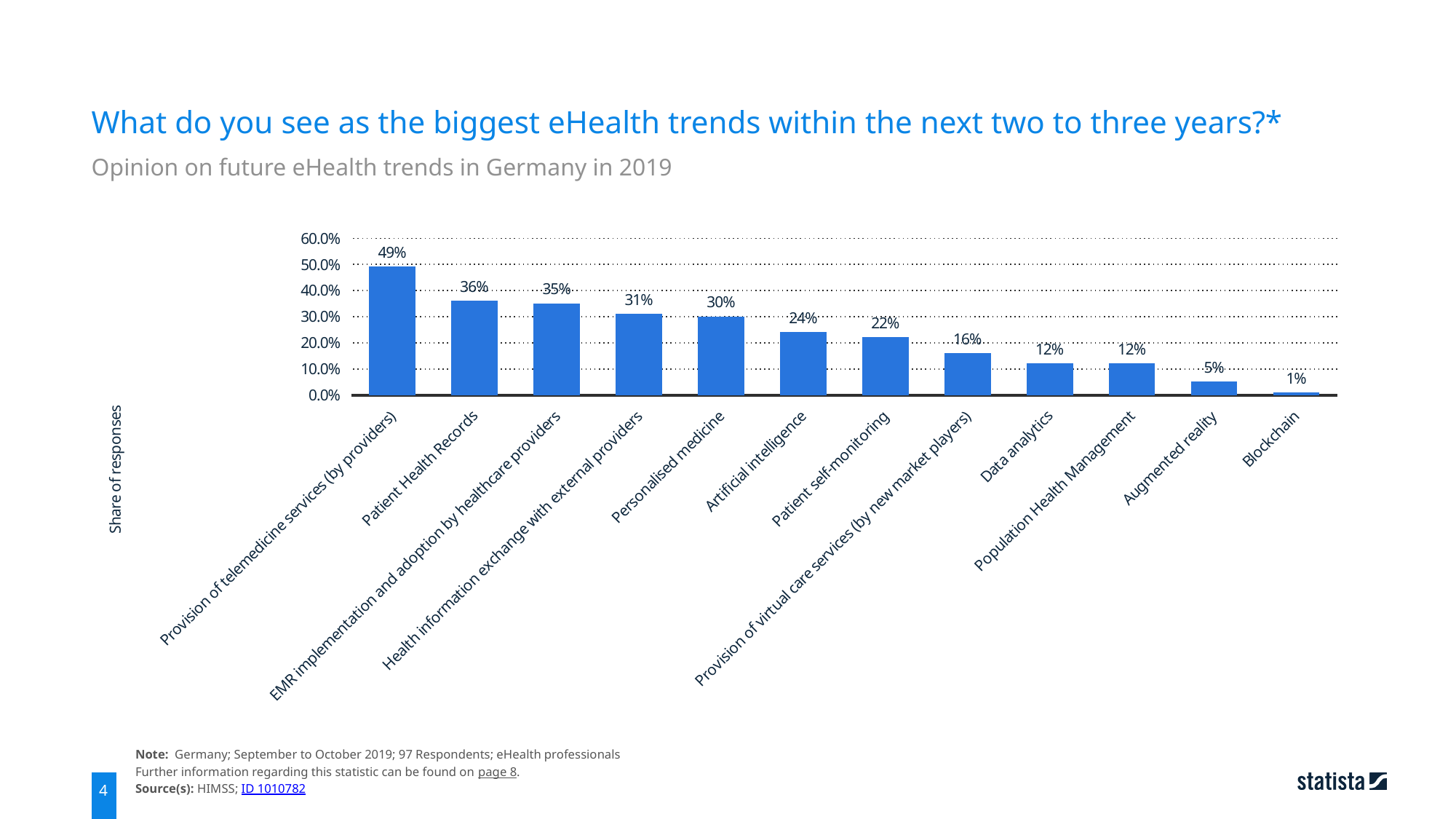
How many categories are shown in the chart? 12 Which category has the lowest share of responses? Blockchain What kind of chart is shown on the slide? Bar chart Is the value for Health information exchange with external providers greater or less than 20.0%? greater Which has a larger share of responses, Personalised medicine or Data analytics? Personalised medicine What is the difference between the shares for Patient Health Records and Patient self-monitoring? 14% What share of responses is shown for Artificial intelligence? 24% Which category has the highest share of responses? Provision of telemedicine services (by providers) Do the values rise or fall from left to right along the x axis? Fall What share of responses is shown for Provision of telemedicine services (by providers)? 49% What share of responses is shown for Augmented reality? 5% What is the label on the vertical axis of the chart? Share of responses